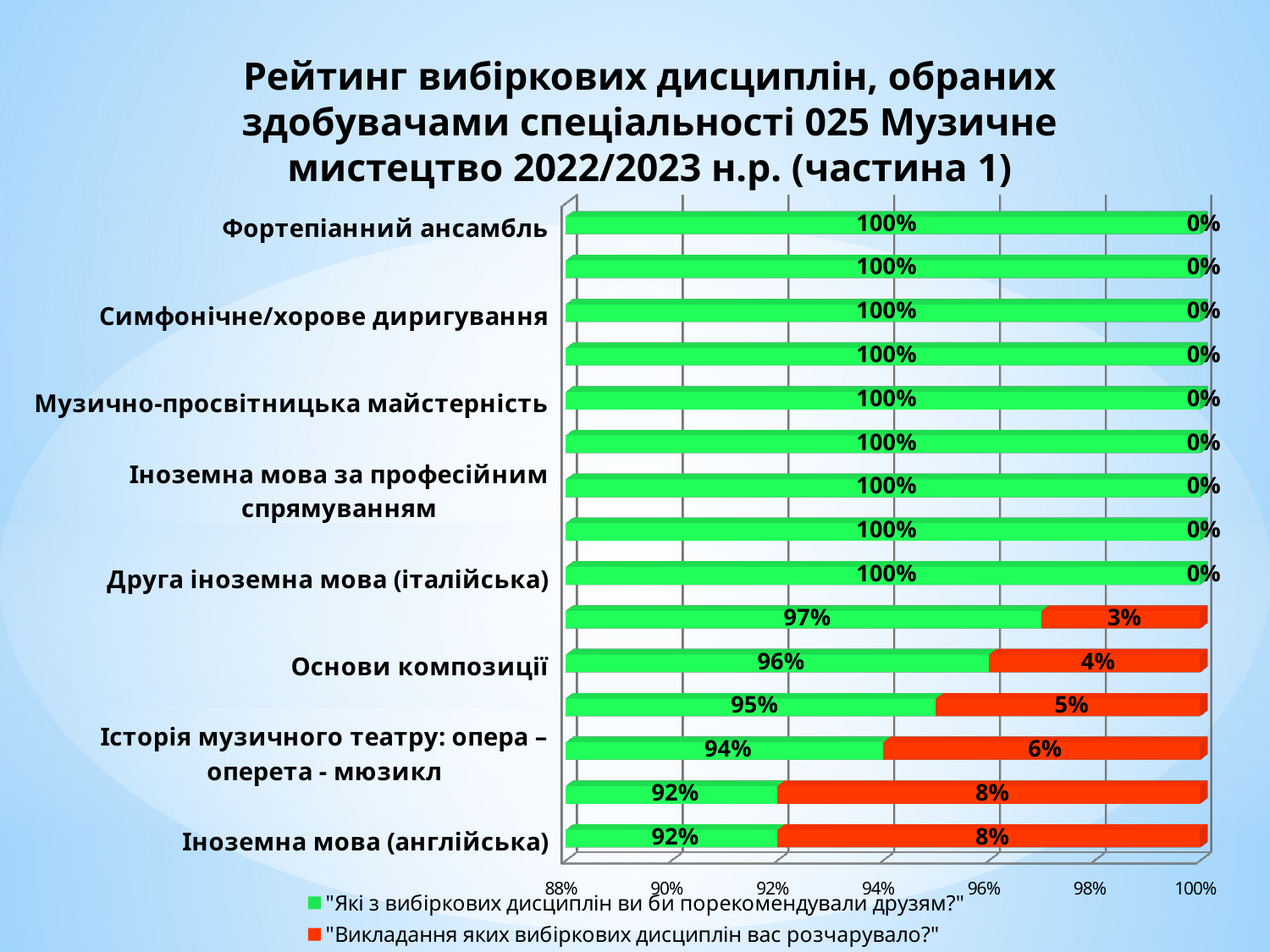
What is the red series value for "Друга іноземна мова (італійська)"? 0% How many bars (disciplines) are plotted in the chart? 15 What kind of chart is shown on the slide? Stacked horizontal bar chart What percentage of respondents would recommend "Основи композиції" to friends (green series)? 96% How many series does the legend list? 2 What is the green series value for "Історія музичного театру: опера – оперета - мюзикл"? 94% What is the value of the red series ("Викладання яких вибіркових дисциплін вас розчарувало?") for "Іноземна мова (англійська)"? 8% Do the green series values rise or fall going from the top bar to the bottom bar? Fall What is the difference between the green series values for "Основи композиції" and "Іноземна мова (англійська)"? 4% Among the labelled disciplines, which has the highest red series value? Іноземна мова (англійська) Which is larger: the green series value for "Основи композиції" or for "Іноземна мова (англійська)"? Основи композиції What is the total of the stacked bar for "Історія музичного театру: опера – оперета - мюзикл"? 100%